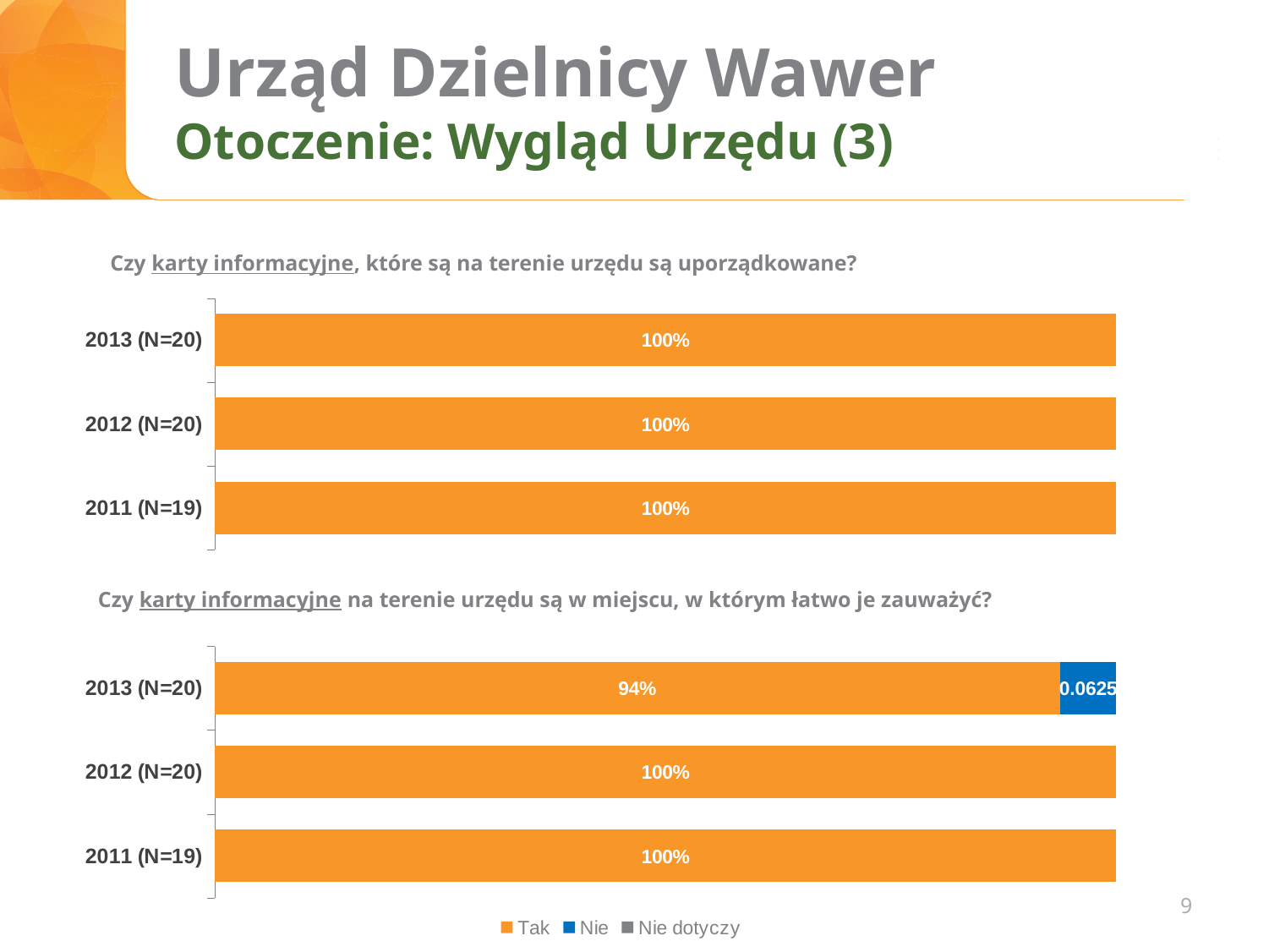
In the top chart ("Czy karty informacyjne, które są na terenie urzędu są uporządkowane?"), what is the value for 2013 (N=20)? 100% In the bottom chart ("Czy karty informacyjne na terenie urzędu są w miejscu, w którym łatwo je zauważyć?"), what is the difference between the Tak value for 2012 (N=20) and the Tak value for 2013 (N=20)? 6% In the bottom chart ("Czy karty informacyjne na terenie urzędu są w miejscu, w którym łatwo je zauważyć?"), which year has the lowest Tak value? 2013 (N=20) In the bottom chart ("Czy karty informacyjne na terenie urzędu są w miejscu, w którym łatwo je zauważyć?"), is the Tak value for 2013 (N=20) larger or smaller than the Tak value for 2012 (N=20)? Smaller In the top chart ("Czy karty informacyjne, które są na terenie urzędu są uporządkowane?"), what is the value for 2011 (N=19)? 100% In the bottom chart ("Czy karty informacyjne na terenie urzędu są w miejscu, w którym łatwo je zauważyć?"), what colour represents the Nie series? Blue In the bottom chart ("Czy karty informacyjne na terenie urzędu są w miejscu, w którym łatwo je zauważyć?"), what is the Tak value for 2013 (N=20)? 94% In the bottom chart ("Czy karty informacyjne na terenie urzędu są w miejscu, w którym łatwo je zauważyć?"), what is the Nie value for 2013 (N=20)? 0.0625 What kind of chart is the top chart ("Czy karty informacyjne, które są na terenie urzędu są uporządkowane?")? Bar chart How many series does the legend at the bottom of the slide list? 3 In the bottom chart ("Czy karty informacyjne na terenie urzędu są w miejscu, w którym łatwo je zauważyć?"), what is the value for 2012 (N=20)? 100% In the top chart ("Czy karty informacyjne, które są na terenie urzędu są uporządkowane?"), how many categories are shown? 3